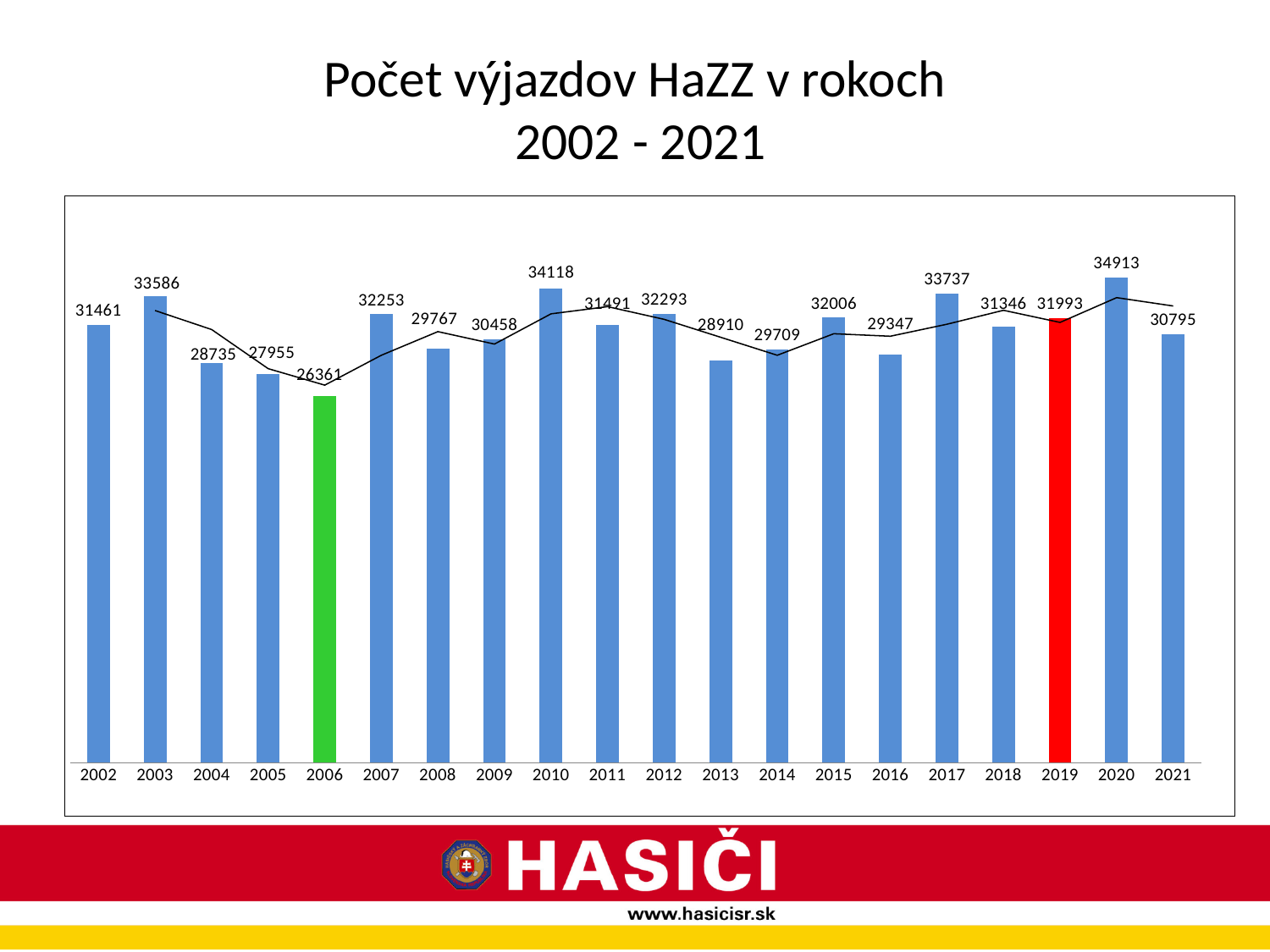
What kind of chart is this? bar chart Which is larger, the value for 2017 or the value for 2018? 2017 What is the difference between the values for 2020 and 2006? 8552 Which year has the lowest value? 2006 What is the difference between the values for 2003 and 2002? 2125 Which year has the highest value? 2020 What is the value for 2006? 26361 Which year's bar is coloured red? 2019 What is the value for 2019? 31993 What is the title of the chart? Počet výjazdov HaZZ v rokoch 2002 - 2021 What is the value for 2010? 34118 How many years are shown on the x axis? 20